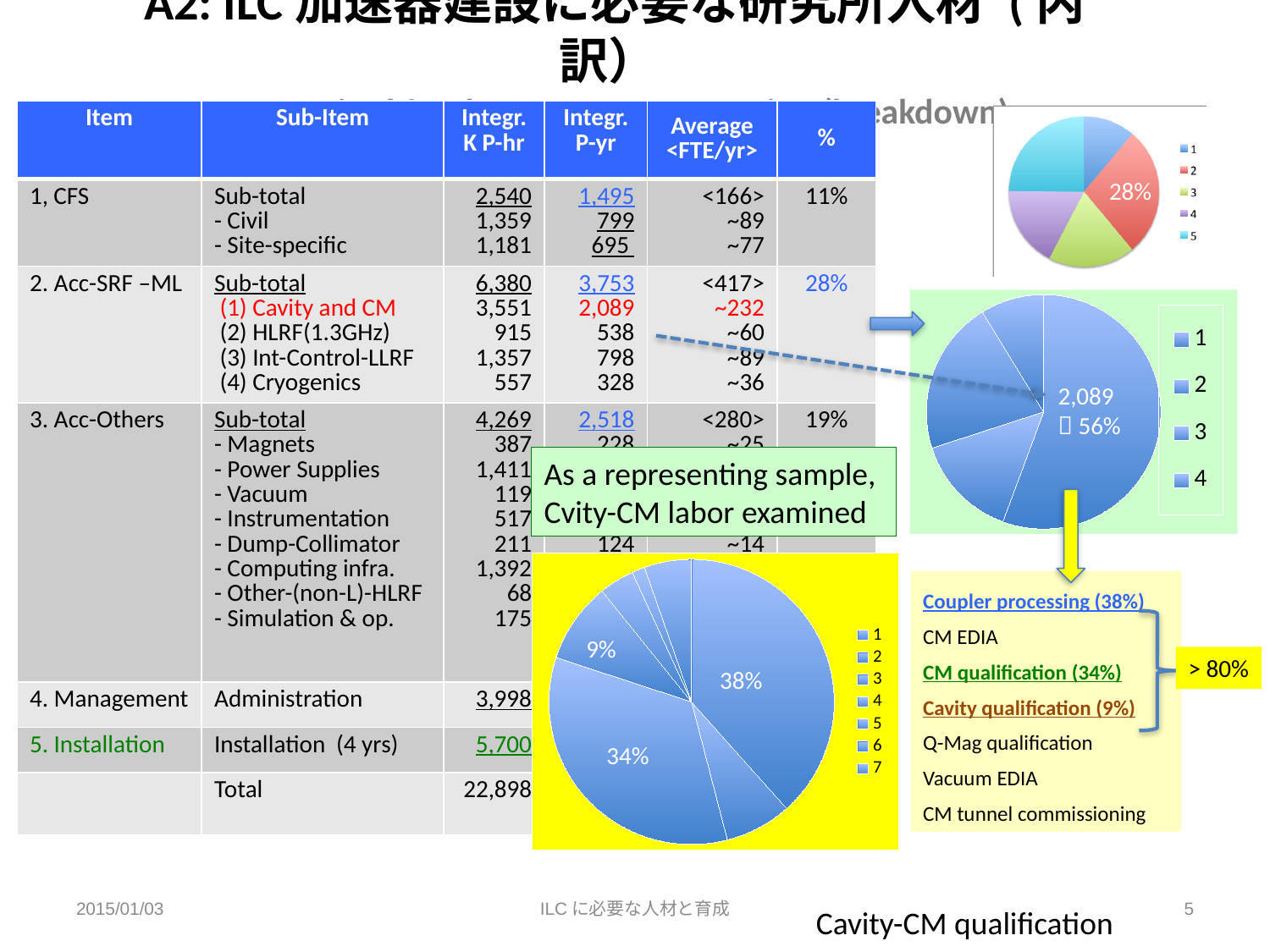
How many entries does the legend of the pie chart on the yellow background list? 7 How many entries does the legend of the top-right pie chart list? 5 What kind of chart is the small chart in the top-right corner of the slide? pie chart In the pie chart on the green background, what share of the pie does the largest slice represent according to its label? 56% How many entries does the legend of the pie chart on the green background list? 4 How many slices does the top-right pie chart have? 5 What kind of chart is shown on the yellow background at the bottom of the slide? pie chart In the top-right pie chart, what percentage is printed on the red slice? 28% In the pie chart on the green background, what value is printed on the largest slice? 2,089 In the pie chart on the yellow background, what is the largest percentage printed on a slice? 38% In the pie chart on the yellow background, which is larger: the slice labelled 38% or the slice labelled 9%? 38% In the pie chart on the yellow background, what is the difference between the 38% slice and the 34% slice? 4%